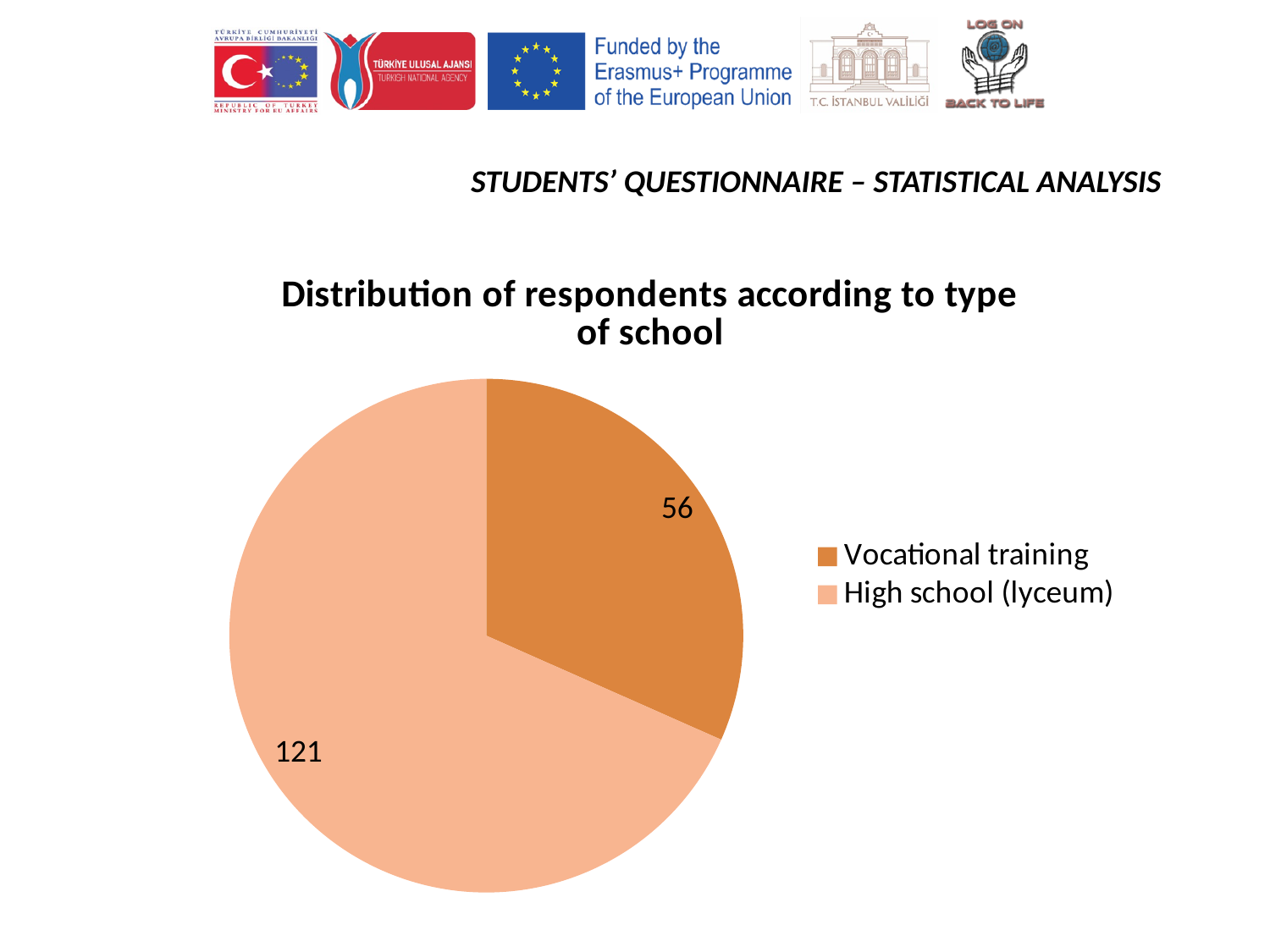
Which is larger: the number of vocational training respondents or the number of high school (lyceum) respondents? High school (lyceum) Which type of school has the most respondents? High school (lyceum) What is the title of the chart? Distribution of respondents according to type of school What is the total number of respondents shown in the pie chart? 177 How many categories does the pie chart show? 2 How many respondents are from high school (lyceum)? 121 Which type of school has the fewest respondents? Vocational training What is the difference between the number of high school (lyceum) respondents and vocational training respondents? 65 Which category is shown in the darker orange colour? Vocational training What type of chart is shown on the slide? pie chart How many respondents are from vocational training? 56